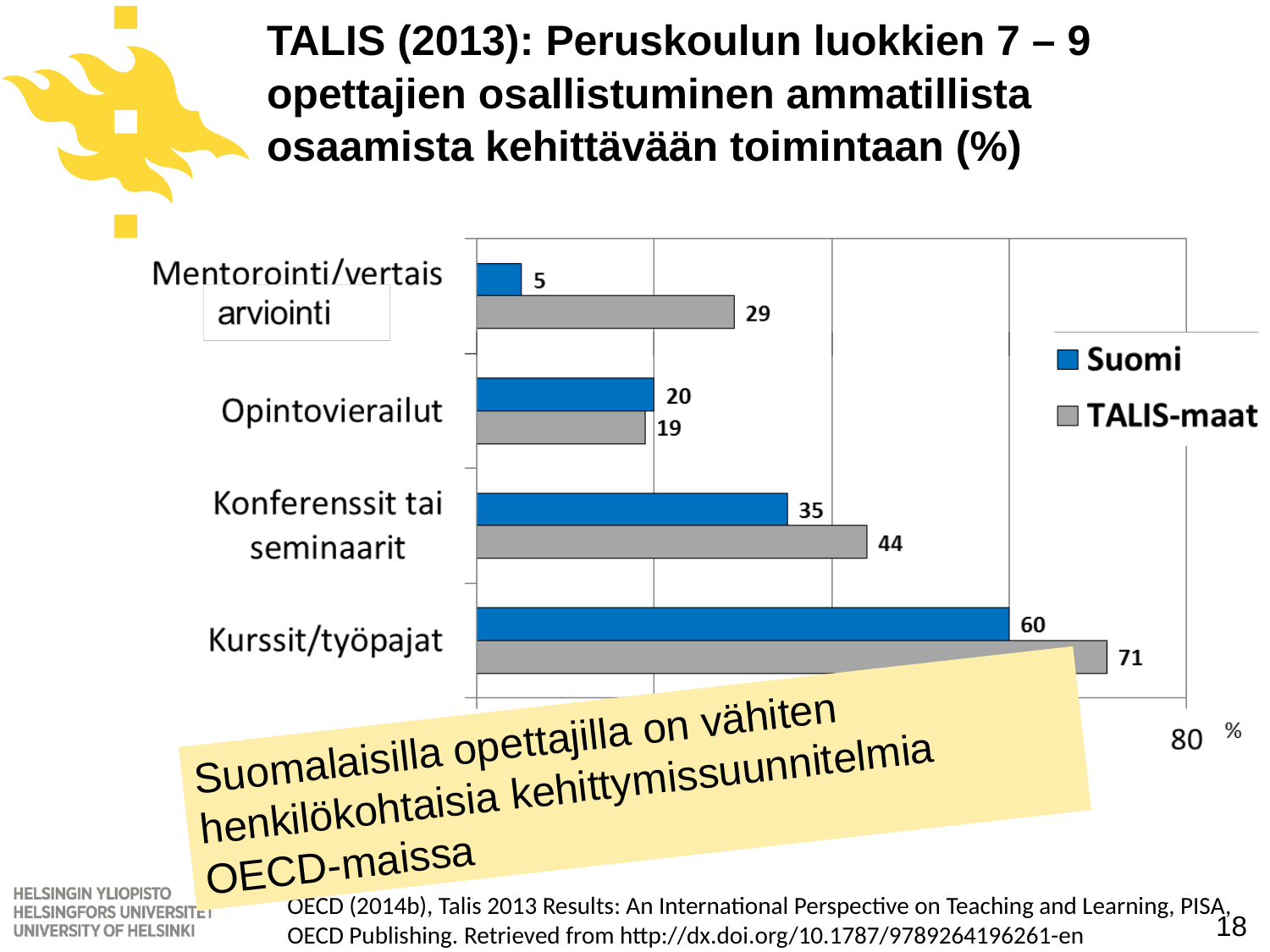
What is the value for TALIS-maat in the Mentorointi/vertaisarviointi category? 29 What is the value for Suomi in the Konferenssit tai seminaarit category? 35 How many series does the legend list? 2 What kind of chart is shown on the slide? Bar chart Which is larger for Konferenssit tai seminaarit, the Suomi value or the TALIS-maat value? TALIS-maat How many categories are shown on the chart? 4 Which category has the lowest value for Suomi? Mentorointi/vertaisarviointi Which category has the highest value for Suomi? Kurssit/työpajat What is the difference between the TALIS-maat and Suomi values for Mentorointi/vertaisarviointi? 24 What is the difference between the TALIS-maat and Suomi values for Kurssit/työpajat? 11 What is the value for TALIS-maat in the Opintovierailut category? 19 What is the value for Suomi in the Kurssit/työpajat category? 60